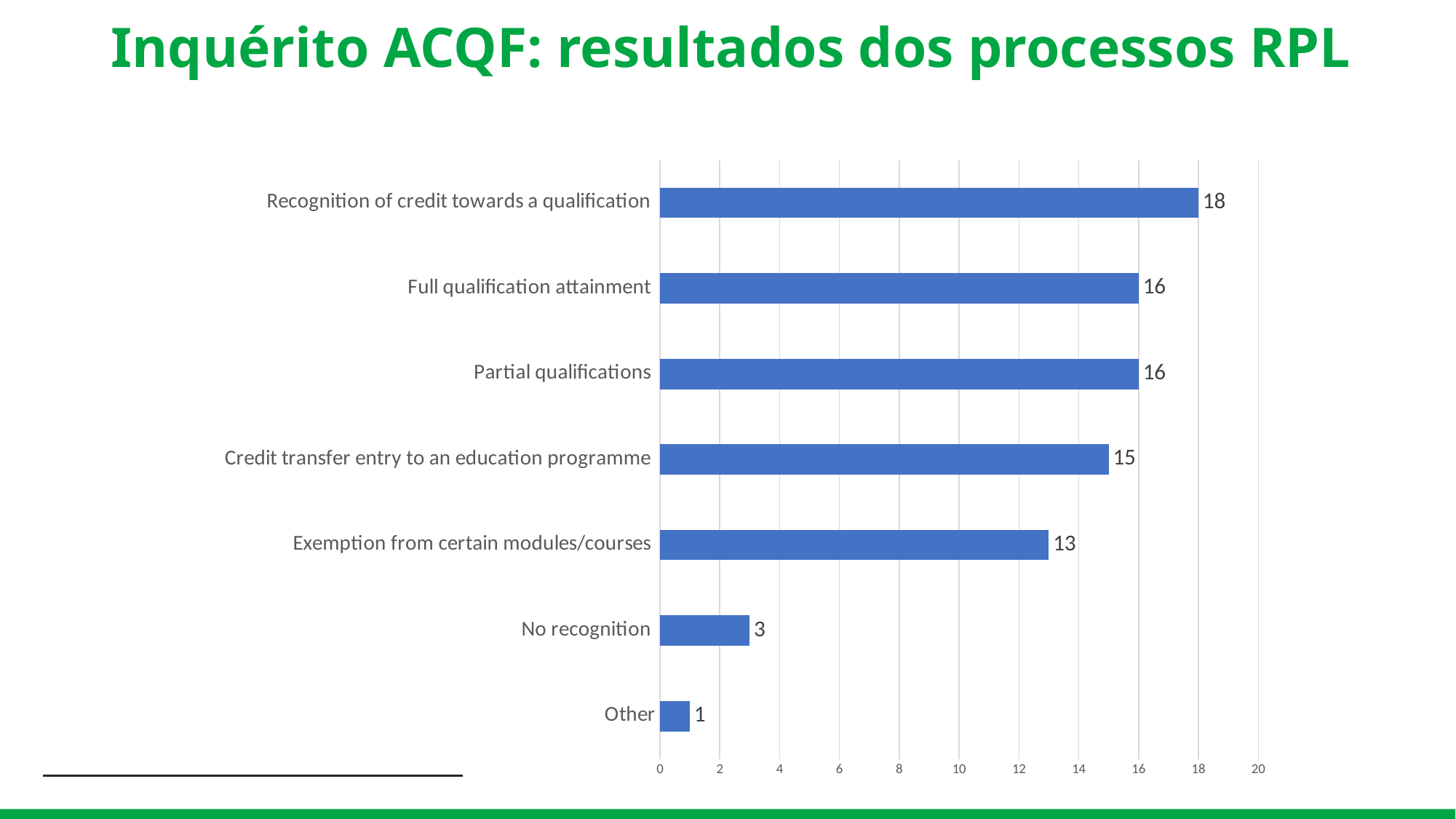
What kind of chart is shown on the slide? Bar chart What is the value for Exemption from certain modules/courses? 13 What is the difference between the values for Exemption from certain modules/courses and No recognition? 10 What is the value for Credit transfer entry to an education programme? 15 How many categories are shown in the chart? 7 What is the title of the slide? Inquérito ACQF: resultados dos processos RPL Which category has the highest value? Recognition of credit towards a qualification Which is larger, the value for Partial qualifications or the value for Credit transfer entry to an education programme? Partial qualifications Which category has the lowest value? Other What is the value for No recognition? 3 What is the value for Recognition of credit towards a qualification? 18 What is the difference between the values for Recognition of credit towards a qualification and Full qualification attainment? 2